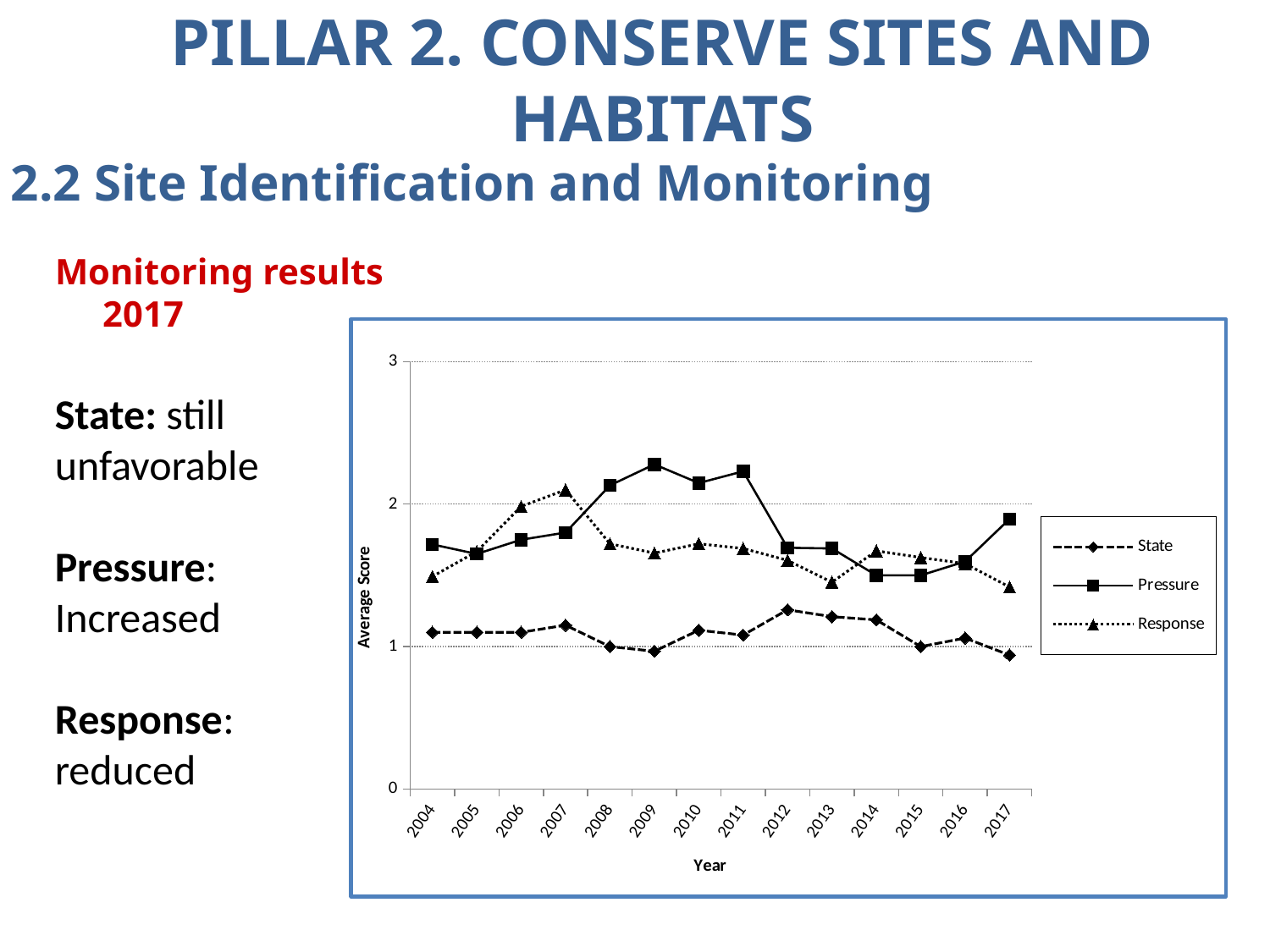
Does the Pressure series rise or fall between 2011 and 2012? Fall In 2017, which is larger: the Pressure value or the Response value? Pressure What kind of chart is shown on the slide? Line chart Which series has the highest value in 2009? Pressure What is the title of the chart's vertical axis? Average Score How many years are plotted along the x axis of the chart? 14 Is the State value for 2017 greater or less than 1? less In 2007, which is larger: the Response value or the Pressure value? Response How many series does the chart's legend list? 3 Which series has the lowest values across all years shown? State Is the Pressure value for 2009 greater or less than 2? greater Is the Pressure value for 2014 greater or less than 2? less